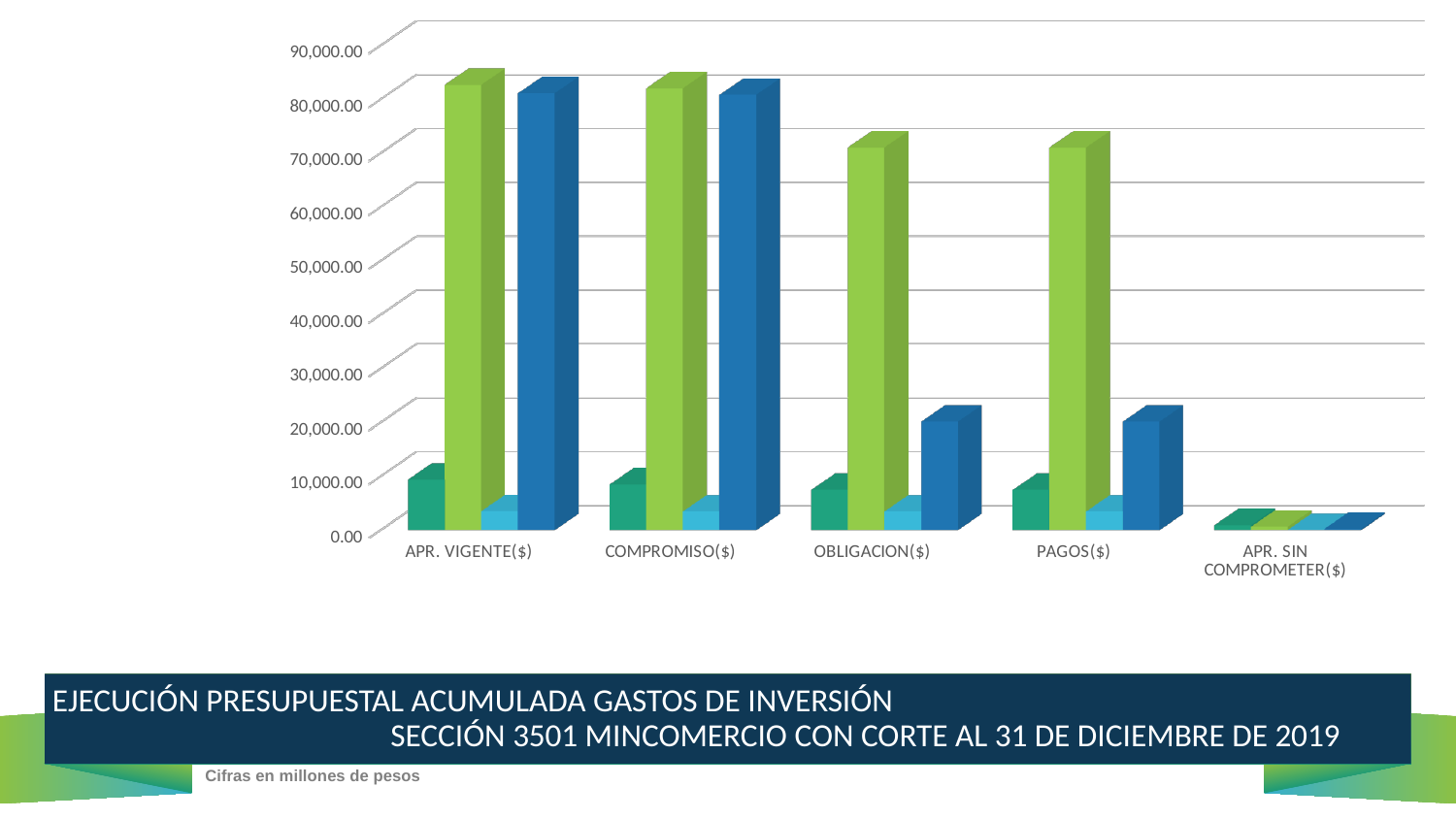
Which category has the lowest values across all its bars? APR. SIN COMPROMETER($) How many categories are shown on the x axis of the chart? 5 Is the value of the light blue bar for COMPROMISO($) greater or less than 10,000.00? less Do the dark blue bars generally rise or fall moving from APR. VIGENTE($) to APR. SIN COMPROMETER($)? fall How many bars are plotted for each category in the chart? 4 What is the highest value shown on the vertical axis of the chart? 90,000.00 Which is larger, the light green bar for APR. VIGENTE($) or the light green bar for OBLIGACION($)? APR. VIGENTE($) Which is larger, the dark blue bar for COMPROMISO($) or the dark blue bar for PAGOS($)? COMPROMISO($) What kind of chart is shown on the slide? bar chart Is the value of the light green bar for APR. VIGENTE($) greater or less than 70,000.00? greater Is the value of the dark blue bar for OBLIGACION($) greater or less than 30,000.00? less